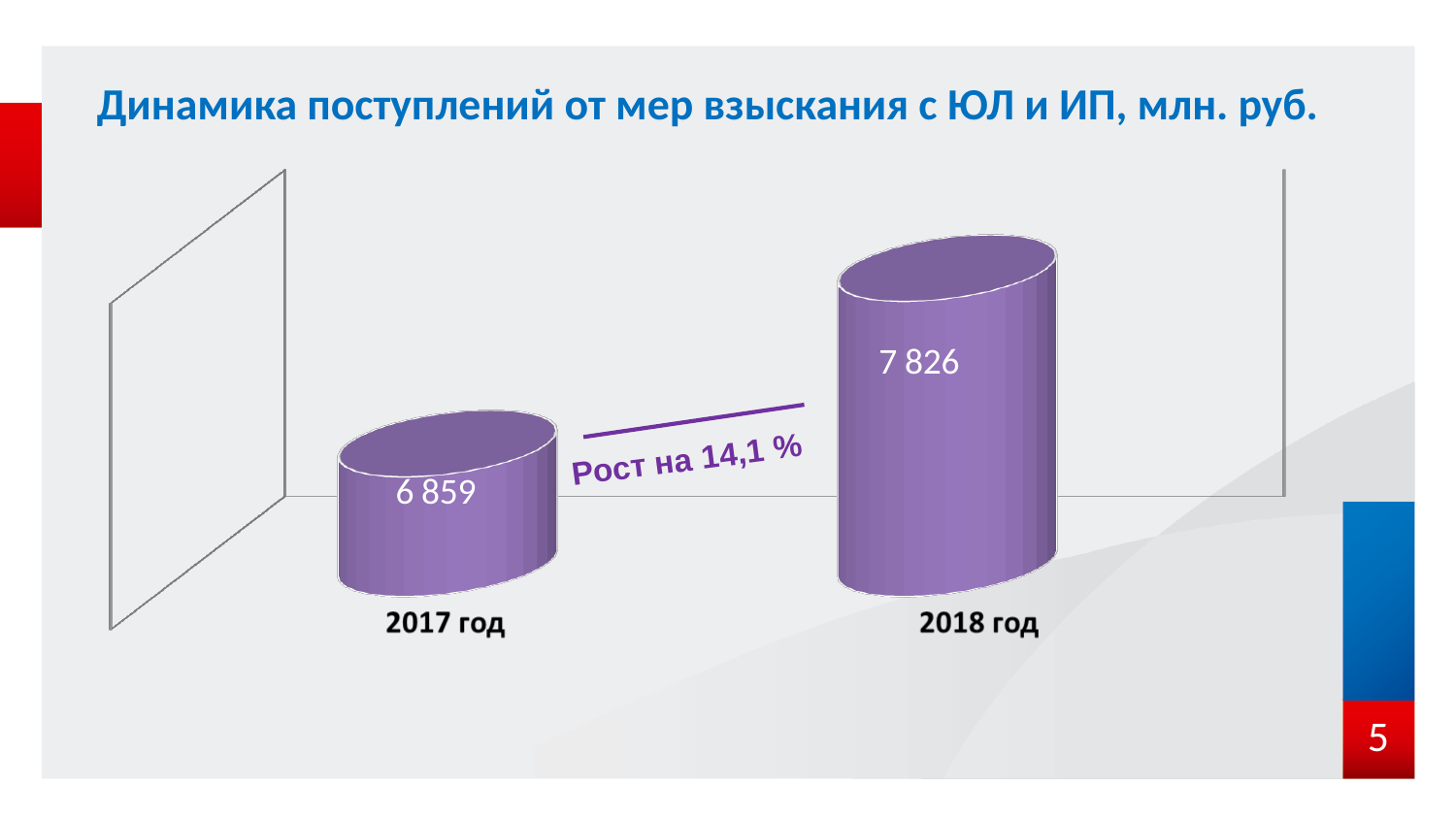
Do the values rise or fall from 2017 год to 2018 год? rise What kind of chart is shown on the slide? bar chart What is the value for 2017 год? 6 859 Is the value for 2018 год larger or smaller than the value for 2017 год? larger What is the difference between the values for 2018 год and 2017 год? 967 How many categories are shown in the chart? 2 Which year has the higher value? 2018 год What is the value for 2018 год? 7 826 What is the title of the chart? Динамика поступлений от мер взыскания с ЮЛ и ИП, млн. руб. What growth percentage is annotated between the two bars? 14,1 % Which year has the lower value? 2017 год